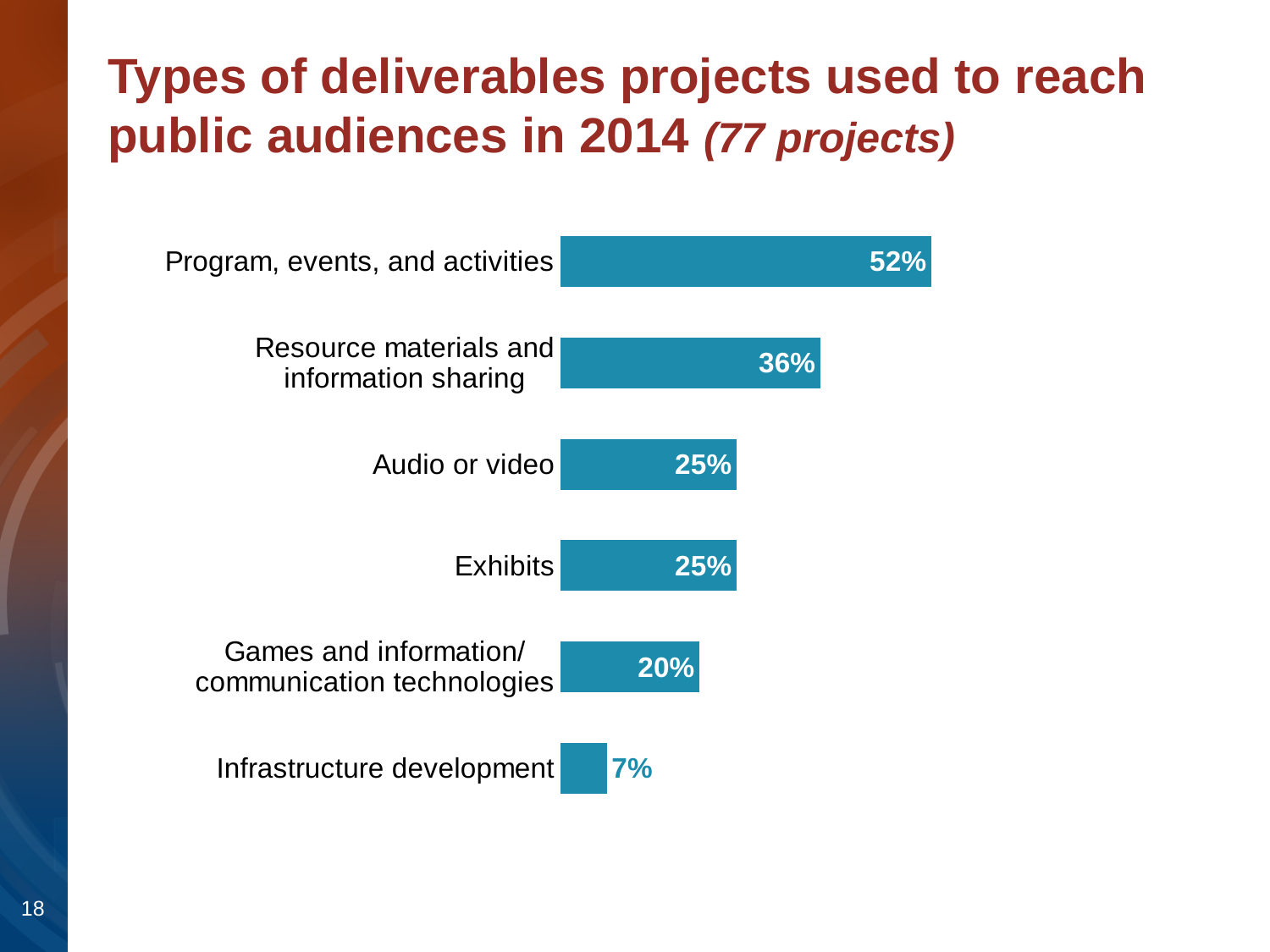
What is the difference in percentage points between Audio or video and Infrastructure development? 18 What is the value shown for Resource materials and information sharing? 36% What percentage is shown for Infrastructure development? 7% Which is larger, the value for Exhibits or the value for Games and information/communication technologies? Exhibits Which type of deliverable has the highest percentage? Program, events, and activities Which type of deliverable has the lowest percentage? Infrastructure development What kind of chart is shown on the slide? Bar chart What percentage of projects used programs, events, and activities to reach public audiences? 52% How many projects does the chart title say the data is based on? 77 projects How many types of deliverables are shown in the chart? 6 What is the difference in percentage points between Program, events, and activities and Resource materials and information sharing? 16 What is the value for Games and information/communication technologies? 20%